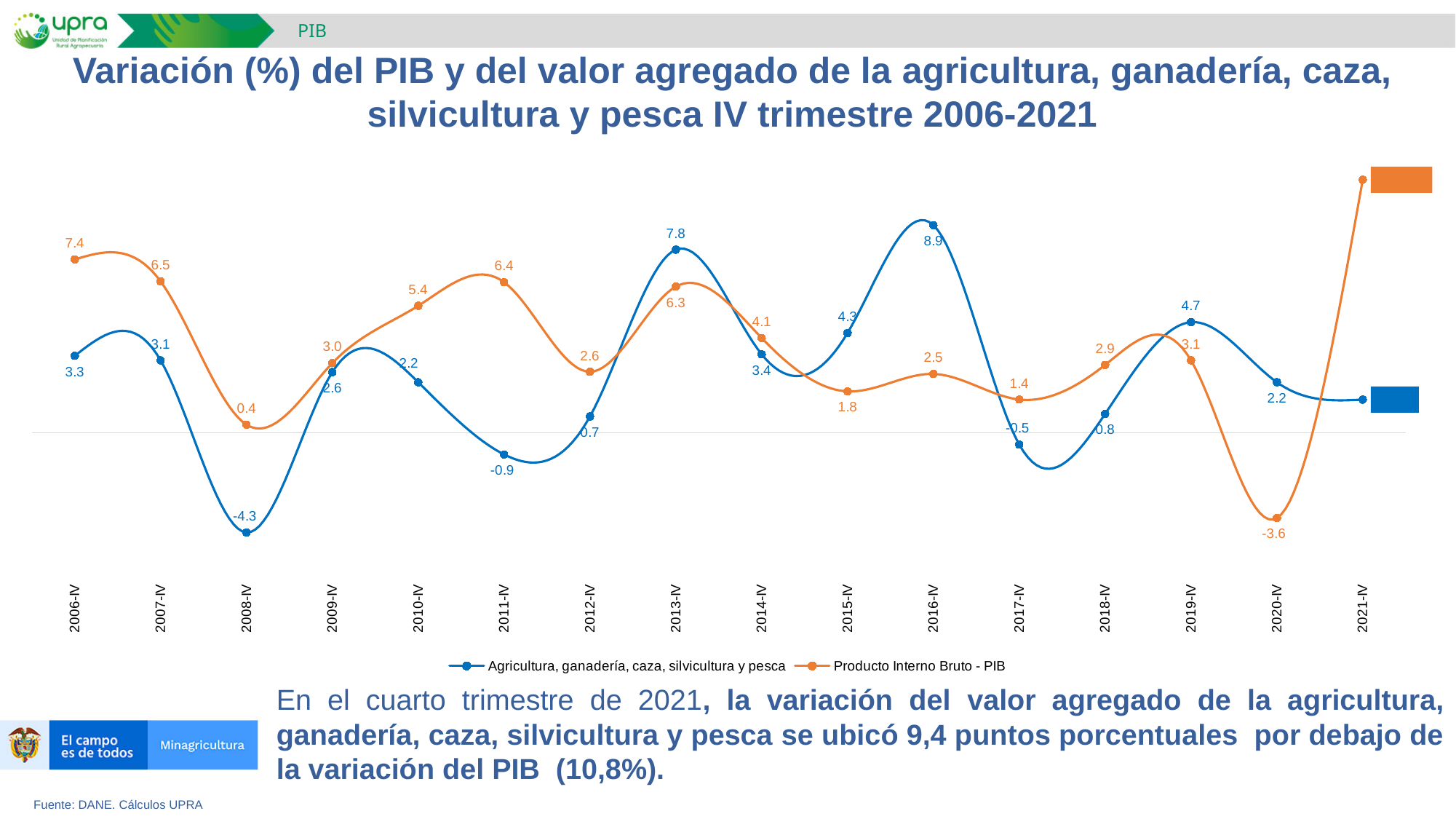
Which series has the larger value in 2006-IV, Agricultura, ganadería, caza, silvicultura y pesca or Producto Interno Bruto - PIB? Producto Interno Bruto - PIB In which period does the Agricultura, ganadería, caza, silvicultura y pesca series reach its lowest value? 2008-IV What kind of chart is shown on the slide? Line chart What is the value for Agricultura, ganadería, caza, silvicultura y pesca in 2016-IV? 8.9 What is the value for Producto Interno Bruto - PIB in 2020-IV? -3.6 How many periods are shown on the x axis? 16 In which period does the Producto Interno Bruto - PIB series reach its highest value? 2021-IV How many series does the legend list? 2 In which period does the Producto Interno Bruto - PIB series reach its lowest value? 2020-IV What is the value for Producto Interno Bruto - PIB in 2010-IV? 5.4 Does the Producto Interno Bruto - PIB series rise or fall from 2006-IV to 2008-IV? Fall What is the difference between the Agricultura series and the PIB series in 2013-IV? 1.5